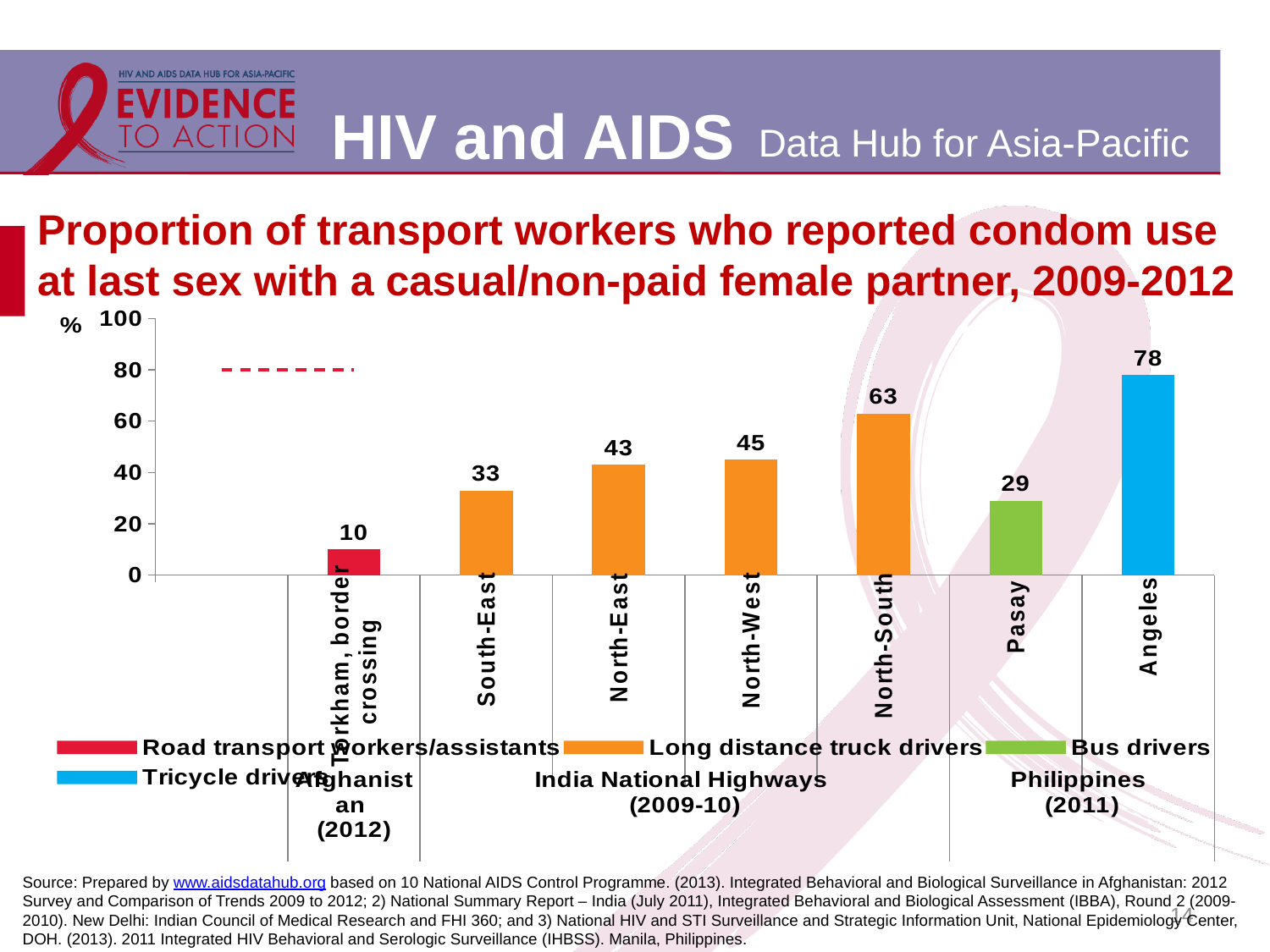
What is the difference between the values for Angeles and Pasay? 49 What is the value for Angeles? 78 Which category has the highest value? Angeles How many bars are plotted in the chart? 7 What kind of chart is shown on the slide? Bar chart Which category has the lowest value? Torkham, border crossing What is the value for Pasay? 29 Which is larger, the value for North-East or the value for South-East? North-East What is the value for Torkham, border crossing? 10 What is the value for North-South? 63 Which legend entry corresponds to the orange bars? Long distance truck drivers How many series does the legend list? 4